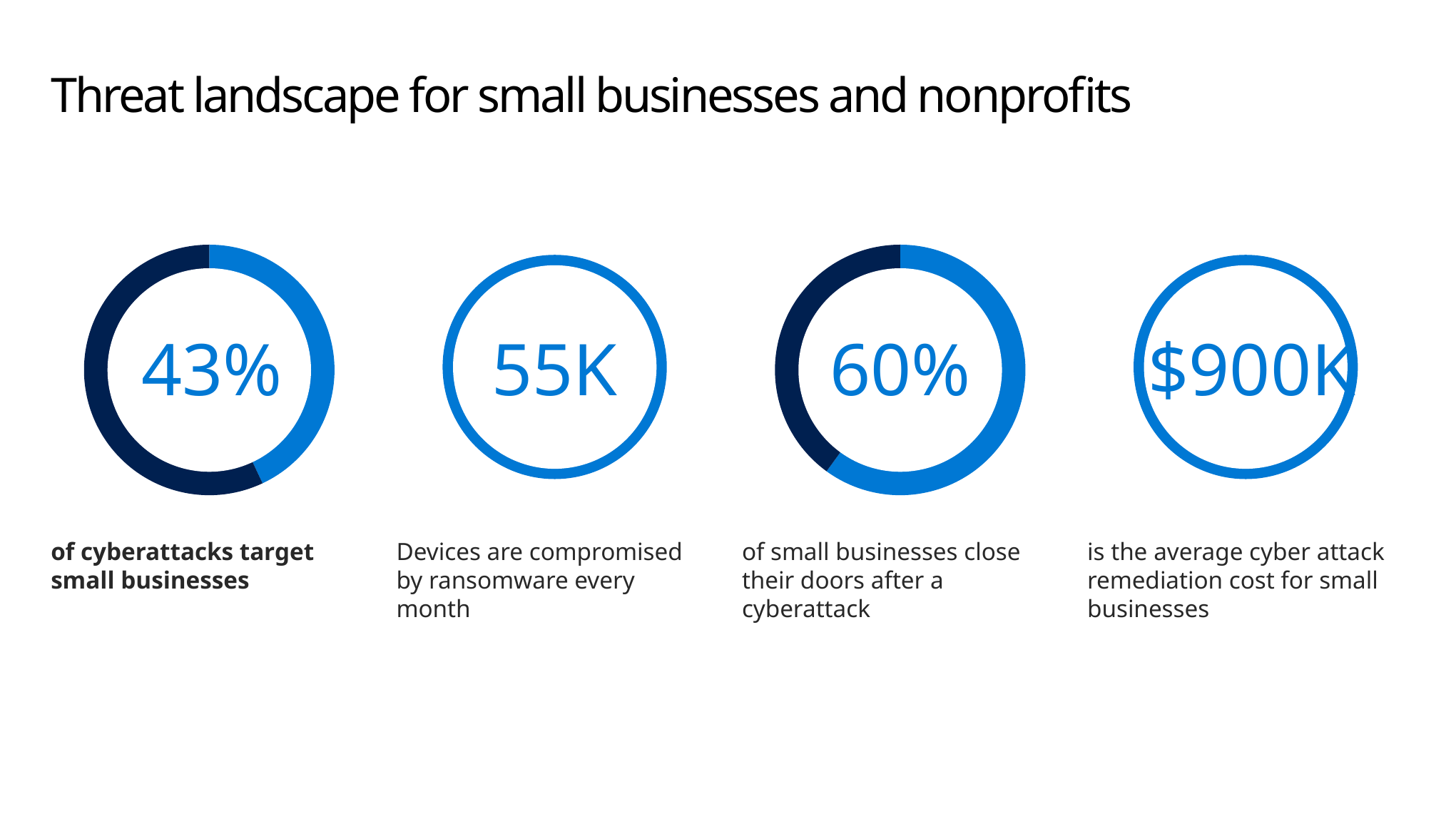
Which is larger: the share of cyberattacks that target small businesses or the share of small businesses that close after a cyberattack? the share of small businesses that close after a cyberattack (60%) Is the value in the first circle (cyberattacks targeting small businesses) greater or less than 50%? less Is the value in the third circle (small businesses closing after a cyberattack) greater or less than 50%? greater How many devices are compromised by ransomware every month, according to the second circle? 55K What kind of chart is used for the 43% and 60% figures on the slide? donut chart What percentage of cyberattacks target small businesses, according to the first circle on the slide? 43% How many circular statistic graphics are shown on the slide? 4 What is the average cyber attack remediation cost for small businesses shown in the fourth circle? $900K What is the title of the slide? Threat landscape for small businesses and nonprofits What is the difference in percentage points between the 60% figure in the third circle and the 43% figure in the first circle? 17 percentage points What percentage of small businesses close their doors after a cyberattack, according to the third circle? 60% In the first donut chart, what colour is the segment representing the 43% share? light blue